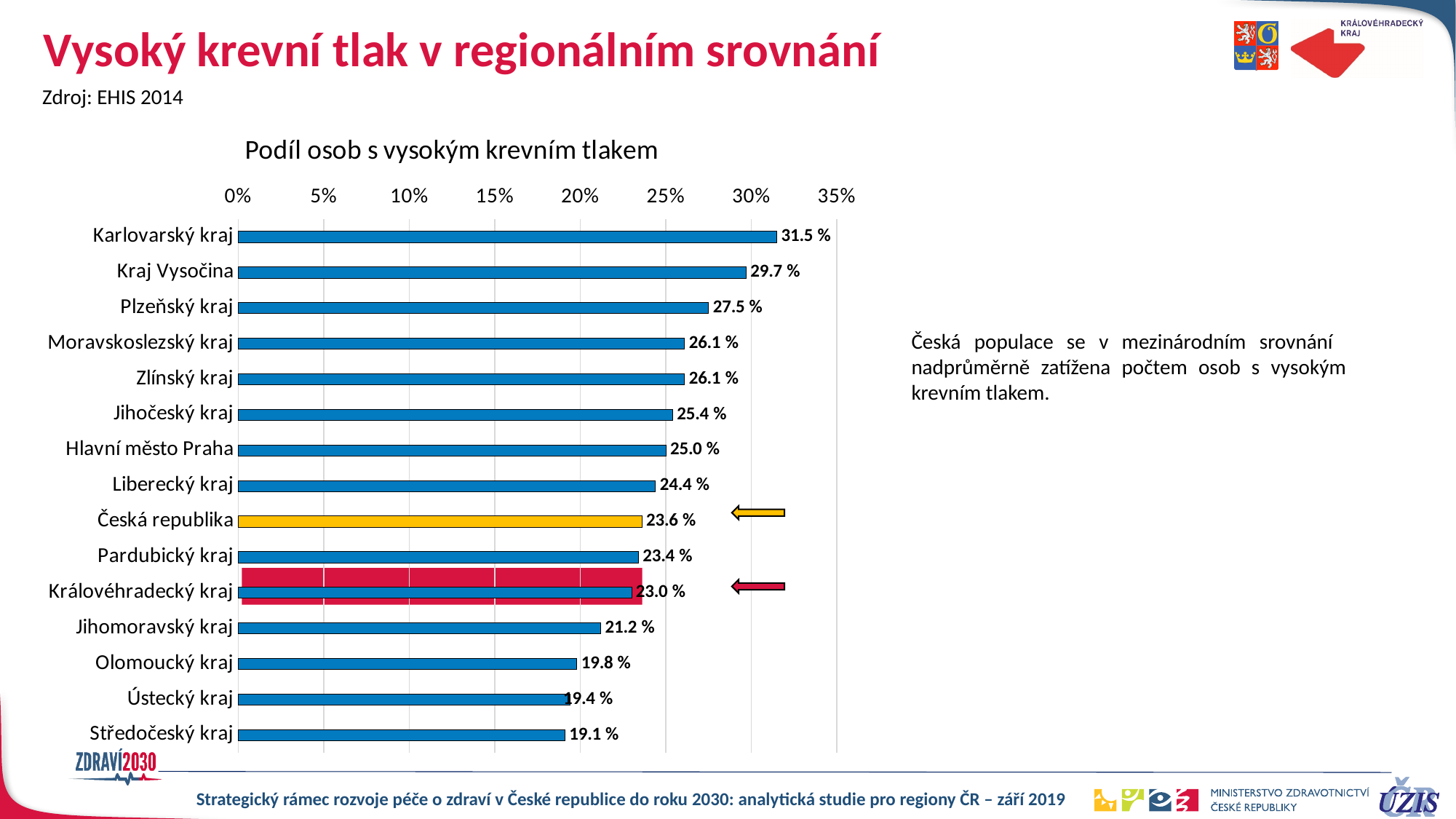
What is the difference between the values for Česká republika and Královéhradecký kraj? 0.6 % Is the value for Jihomoravský kraj greater or less than 20%? greater What kind of chart is shown on the slide? bar chart What is the value for Česká republika? 23.6 % What is the title of the chart? Podíl osob s vysokým krevním tlakem What is the difference between the values for Karlovarský kraj and Středočeský kraj? 12.4 % How many categories are shown on the chart? 15 What is the value for Karlovarský kraj? 31.5 % Which is larger, the value for Kraj Vysočina or the value for Plzeňský kraj? Kraj Vysočina Which category has the lowest value? Středočeský kraj Which category has the highest value? Karlovarský kraj What is the value for Královéhradecký kraj? 23.0 %